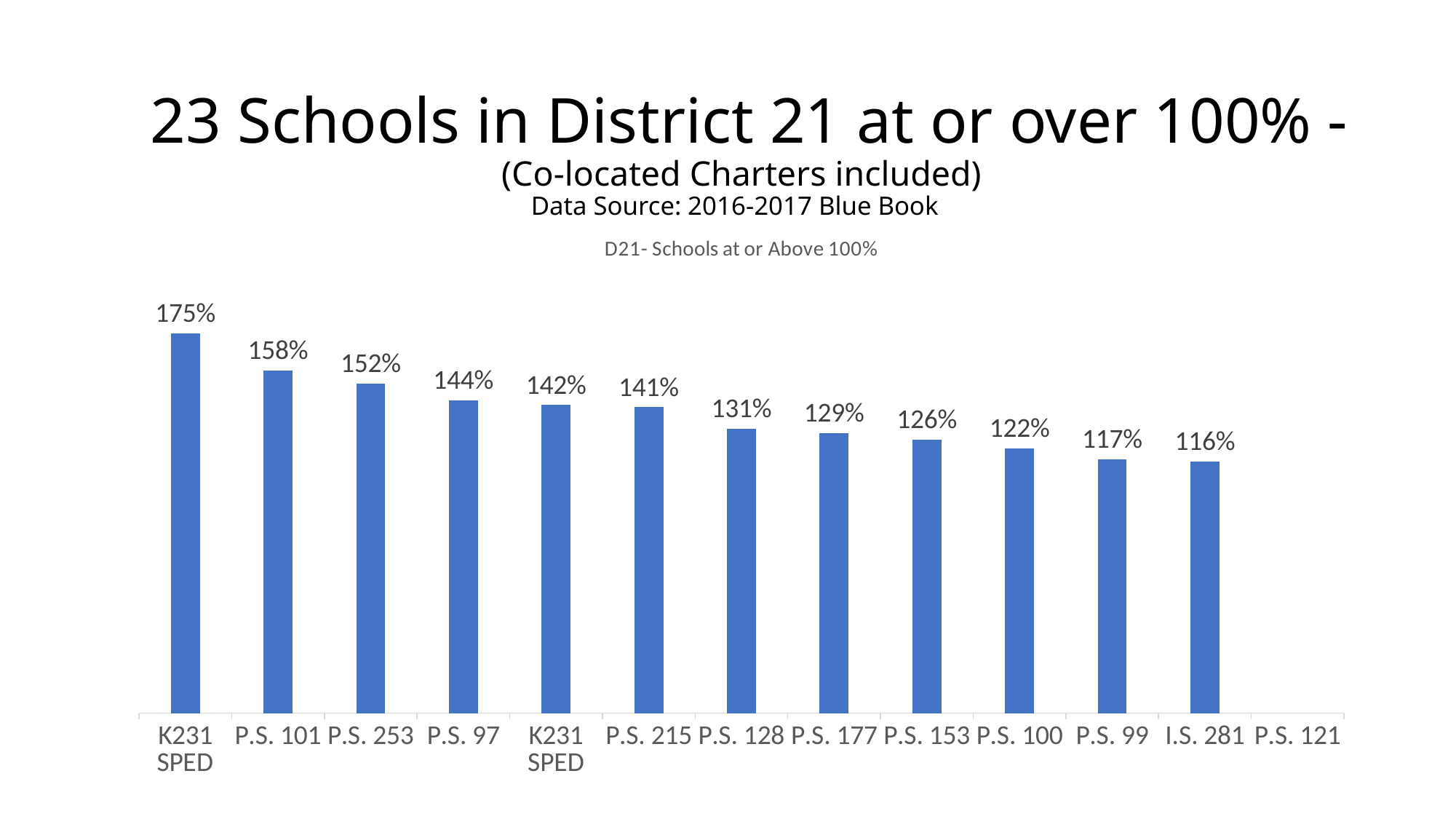
What is the difference between the values for P.S. 101 and P.S. 97? 14% What is the value for P.S. 215? 141% Which has a larger value, P.S. 177 or P.S. 100? P.S. 177 What is the title printed directly above the chart? D21- Schools at or Above 100% Which school has the highest value in the chart? K231 SPED What is the value for P.S. 101? 158% Do the values rise or fall from left to right across the chart? fall What is the value for I.S. 281? 116% What kind of chart is shown on the slide? bar chart What is the value for P.S. 253? 152% What is the difference between the values for P.S. 128 and P.S. 99? 14% What is the value for P.S. 153? 126%